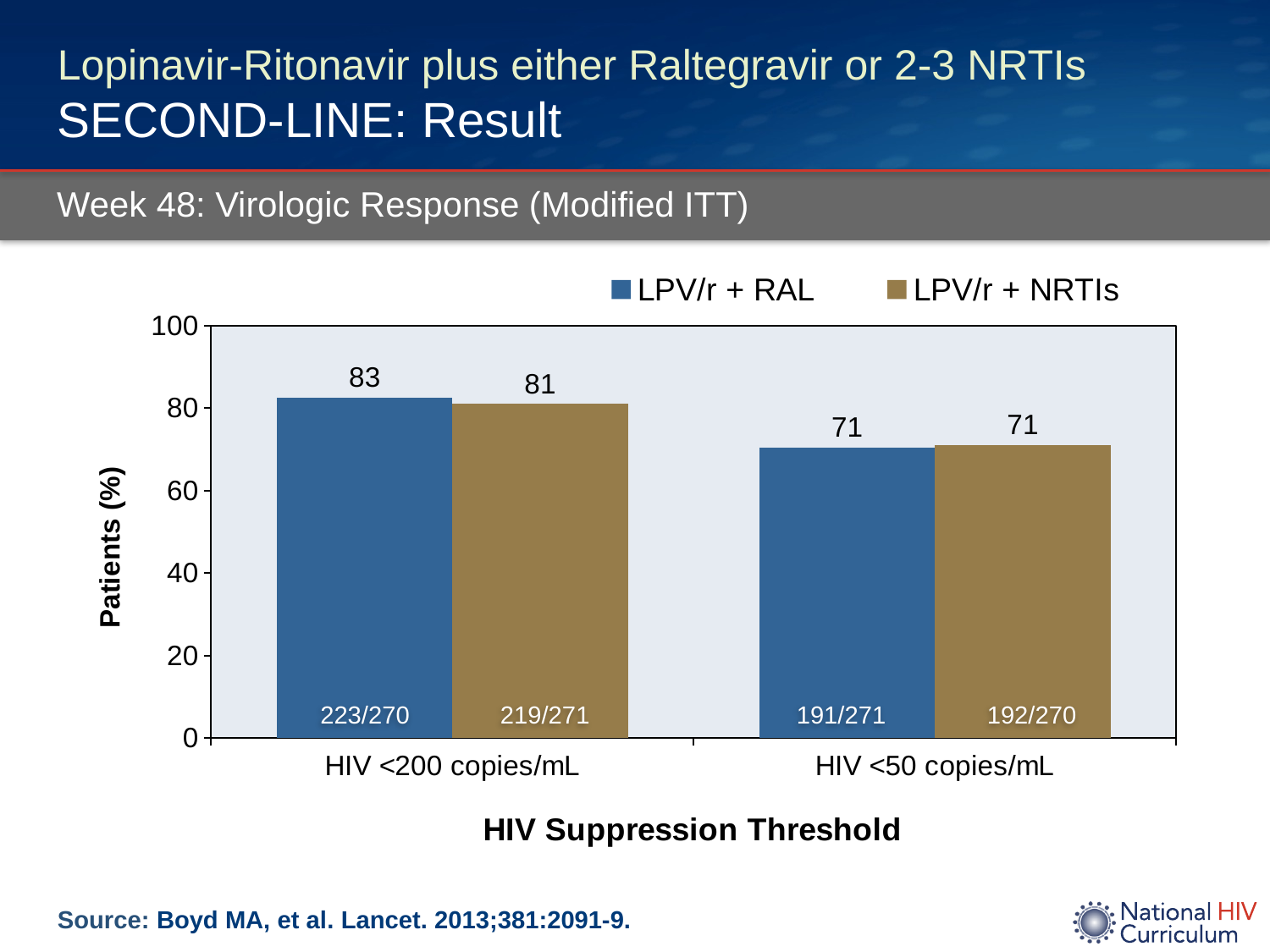
What is the value for LPV/r + RAL at HIV <50 copies/mL? 71 What kind of chart is shown on the slide? bar chart What is the difference between the LPV/r + RAL and LPV/r + NRTIs values at HIV <200 copies/mL? 2 What is the value for LPV/r + RAL at HIV <200 copies/mL? 83 What is the value for LPV/r + NRTIs at HIV <50 copies/mL? 71 Is the value for LPV/r + NRTIs at HIV <50 copies/mL greater or less than 80? less What is the difference between the LPV/r + RAL values at HIV <200 copies/mL and HIV <50 copies/mL? 12 How many series does the legend list? 2 What is the label of the y axis? Patients (%) What fraction is printed inside the LPV/r + RAL bar at HIV <200 copies/mL? 223/270 How many categories are shown on the x axis? 2 What is the value for LPV/r + NRTIs at HIV <200 copies/mL? 81